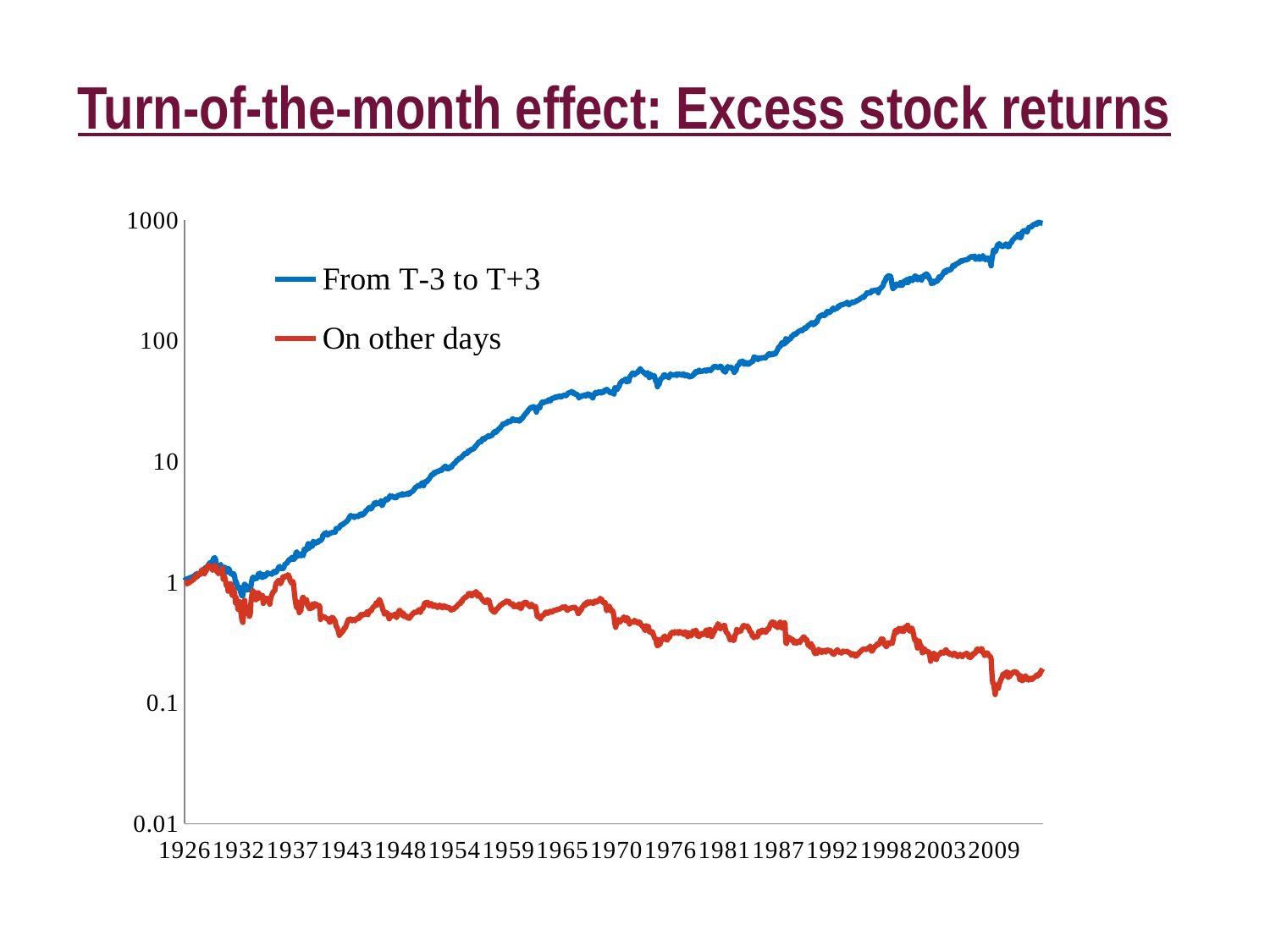
Is the value for 'From T-3 to T+3' at 2009 greater or less than 100? greater How many year labels are shown on the x axis? 16 Is the value for 'From T-3 to T+3' at 1970 greater or less than 10? greater At 2009, which series has the higher value, 'From T-3 to T+3' or 'On other days'? From T-3 to T+3 How many series does the legend list? 2 Is the value for 'On other days' at 2009 greater or less than 1? less What is the title of the slide's chart? Turn-of-the-month effect: Excess stock returns What kind of chart is shown on the slide? line chart Does the 'From T-3 to T+3' series rise or fall overall from 1926 to 2009? rise What are the two series named in the legend? From T-3 to T+3; On other days Does the 'On other days' series rise or fall overall from 1926 to 2009? fall